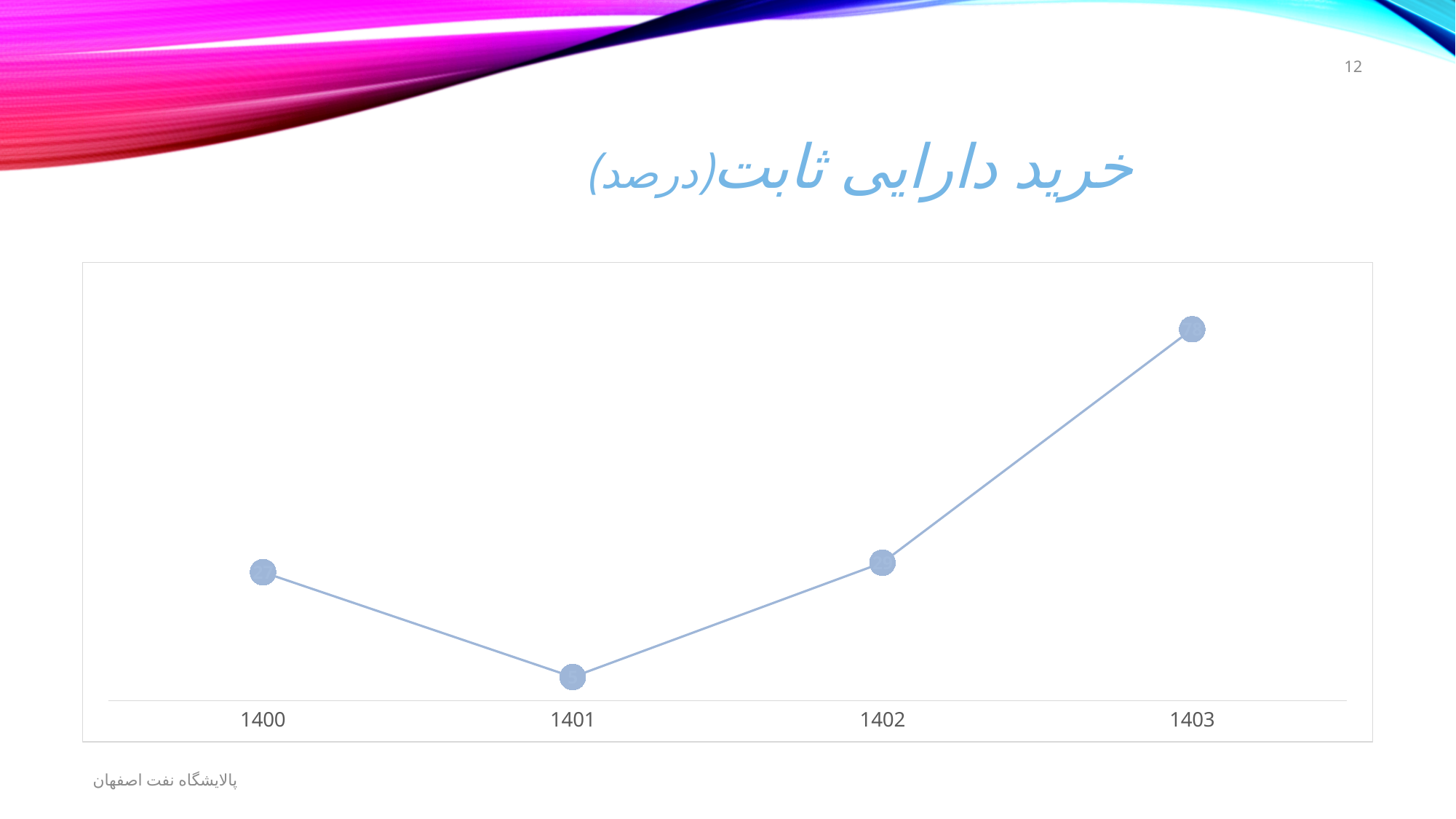
What is the title of the slide above the chart? خرید دارایی ثابت(درصد) How many data points are plotted on the line chart? 4 Which year has the larger value, 1401 or 1402? 1402 Which year has the larger value, 1400 or 1401? 1400 What kind of chart is shown on the slide? line chart Which year has the lowest value on the chart? 1401 Does the value rise or fall from 1400 to 1401? fall Does the value rise or fall from 1401 to 1403? rise What is the first year shown on the x axis? 1400 Which year has the highest value on the chart? 1403 Which year has the larger value, 1402 or 1403? 1403